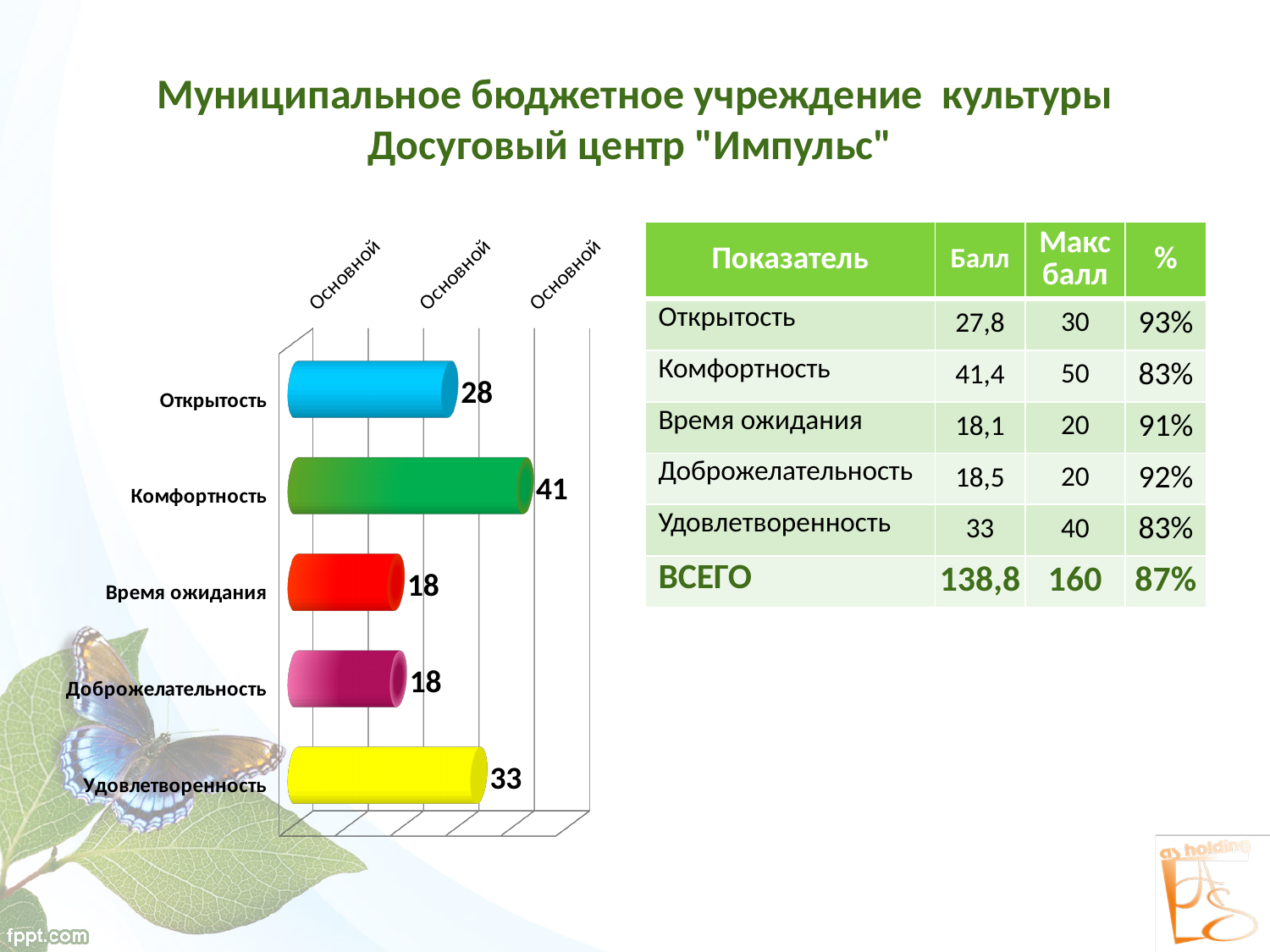
What is the value for Время ожидания in the chart? 18 Which is larger in the chart, the value for Удовлетворенность or the value for Открытость? Удовлетворенность What is the value for Открытость in the chart? 28 What is the difference between the values for Удовлетворенность and Доброжелательность in the chart? 15 What colour is the bar for Удовлетворенность in the chart? yellow What is the difference between the values for Комфортность and Открытость in the chart? 13 What is the value for Комфортность in the chart? 41 Which two categories in the chart have the same value? Время ожидания and Доброжелательность What is the value for Удовлетворенность in the chart? 33 Which category has the highest value in the chart? Комфортность How many categories does the chart show? 5 What type of chart is shown on the slide? bar chart